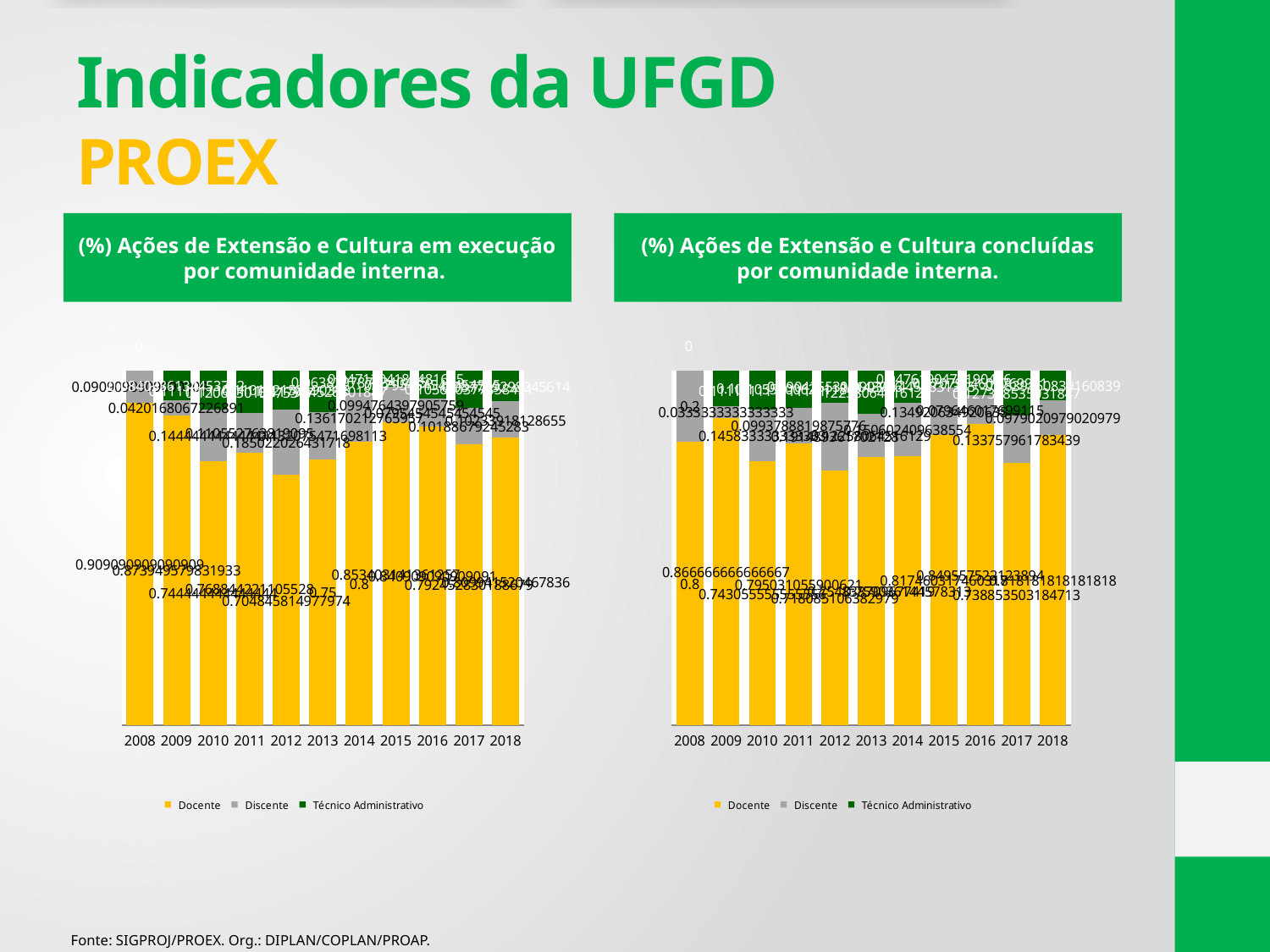
In the right chart, which series is shown in green? Técnico Administrativo In the left chart, how many years are shown on the x axis? 11 In the right chart, what is the Docente value for 2018? 0.818181818181818 In the right chart, what is the Docente value for 2009? 0.866666666666667 In the right chart, what is the Discente value for 2008? 0.2 In the right chart, what is the Docente value for 2008? 0.8 In the right chart, which years are shown on the x axis? 2008 to 2018 How many series does the legend of the right chart, '(%) Ações de Extensão e Cultura concluídas por comunidade interna.', list? 3 In the left chart, which series makes up the largest share of every bar? Docente What kind of chart is the left chart, '(%) Ações de Extensão e Cultura em execução por comunidade interna.'? Stacked bar chart In the left chart, what is the Docente value for 2008? 0.909090909090909 In the right chart, is the Docente value for 2008 larger or smaller than the Docente value for 2009? smaller